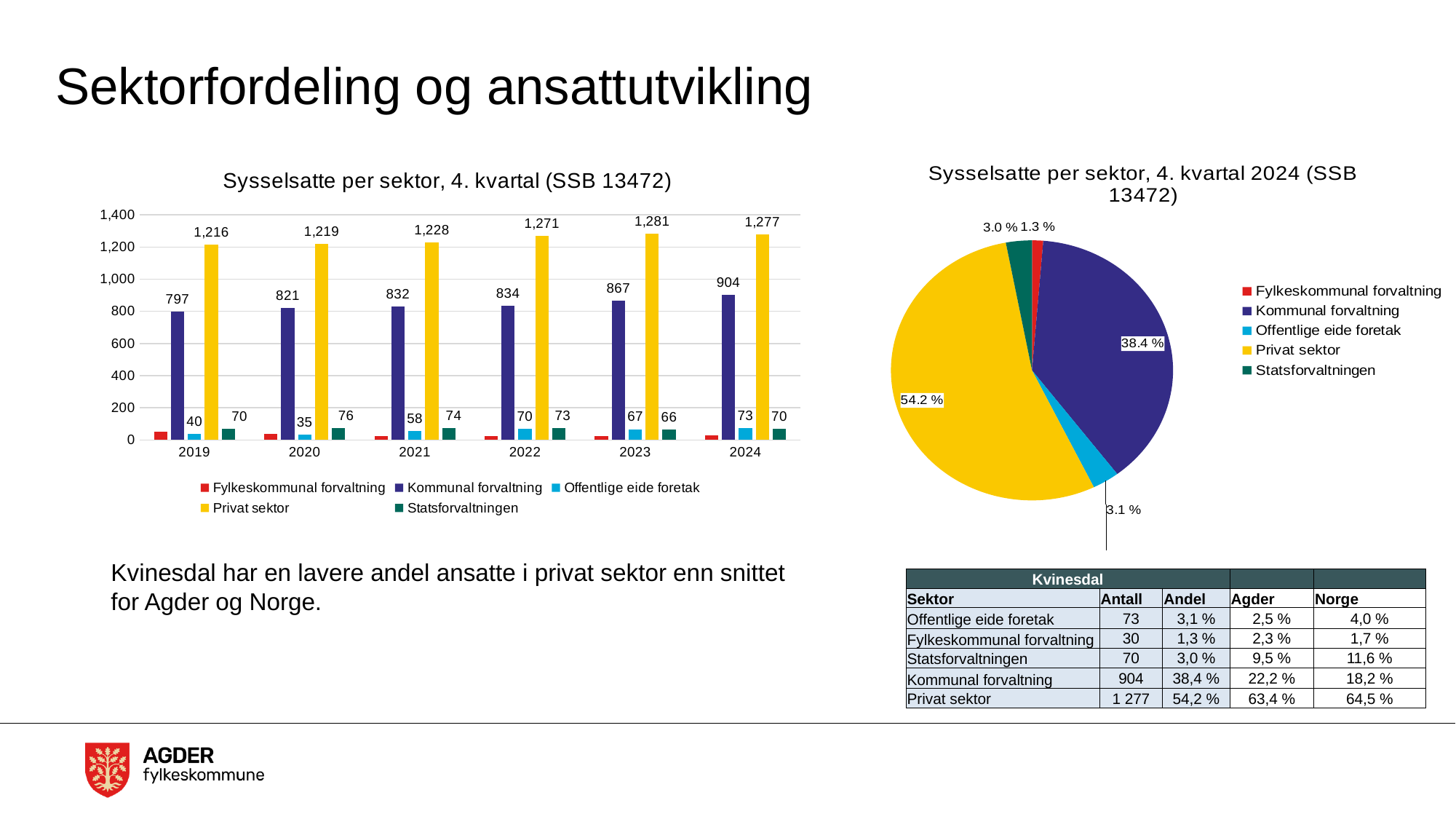
How many years are shown on the x axis of the bar chart 'Sysselsatte per sektor, 4. kvartal (SSB 13472)'? 6 In the bar chart 'Sysselsatte per sektor, 4. kvartal (SSB 13472)', what is the value for Offentlige eide foretak in 2020? 35 In the bar chart 'Sysselsatte per sektor, 4. kvartal (SSB 13472)', which is larger in 2022: Offentlige eide foretak or Statsforvaltningen? Statsforvaltningen In the bar chart 'Sysselsatte per sektor, 4. kvartal (SSB 13472)', does Kommunal forvaltning rise or fall from 2019 to 2024? rise In the bar chart 'Sysselsatte per sektor, 4. kvartal (SSB 13472)', what is the value for Privat sektor in 2024? 1,277 In the bar chart 'Sysselsatte per sektor, 4. kvartal (SSB 13472)', what is the difference between Kommunal forvaltning in 2024 and in 2019? 107 In the pie chart 'Sysselsatte per sektor, 4. kvartal 2024 (SSB 13472)', what share does Privat sektor have? 54.2 % In the bar chart 'Sysselsatte per sektor, 4. kvartal (SSB 13472)', what is the value for Kommunal forvaltning in 2019? 797 How many series does the legend of the bar chart 'Sysselsatte per sektor, 4. kvartal (SSB 13472)' list? 5 In the bar chart 'Sysselsatte per sektor, 4. kvartal (SSB 13472)', in which year is Statsforvaltningen lowest? 2023 In the bar chart 'Sysselsatte per sektor, 4. kvartal (SSB 13472)', in which year is Privat sektor highest? 2023 What kind of chart is 'Sysselsatte per sektor, 4. kvartal 2024 (SSB 13472)'? pie chart